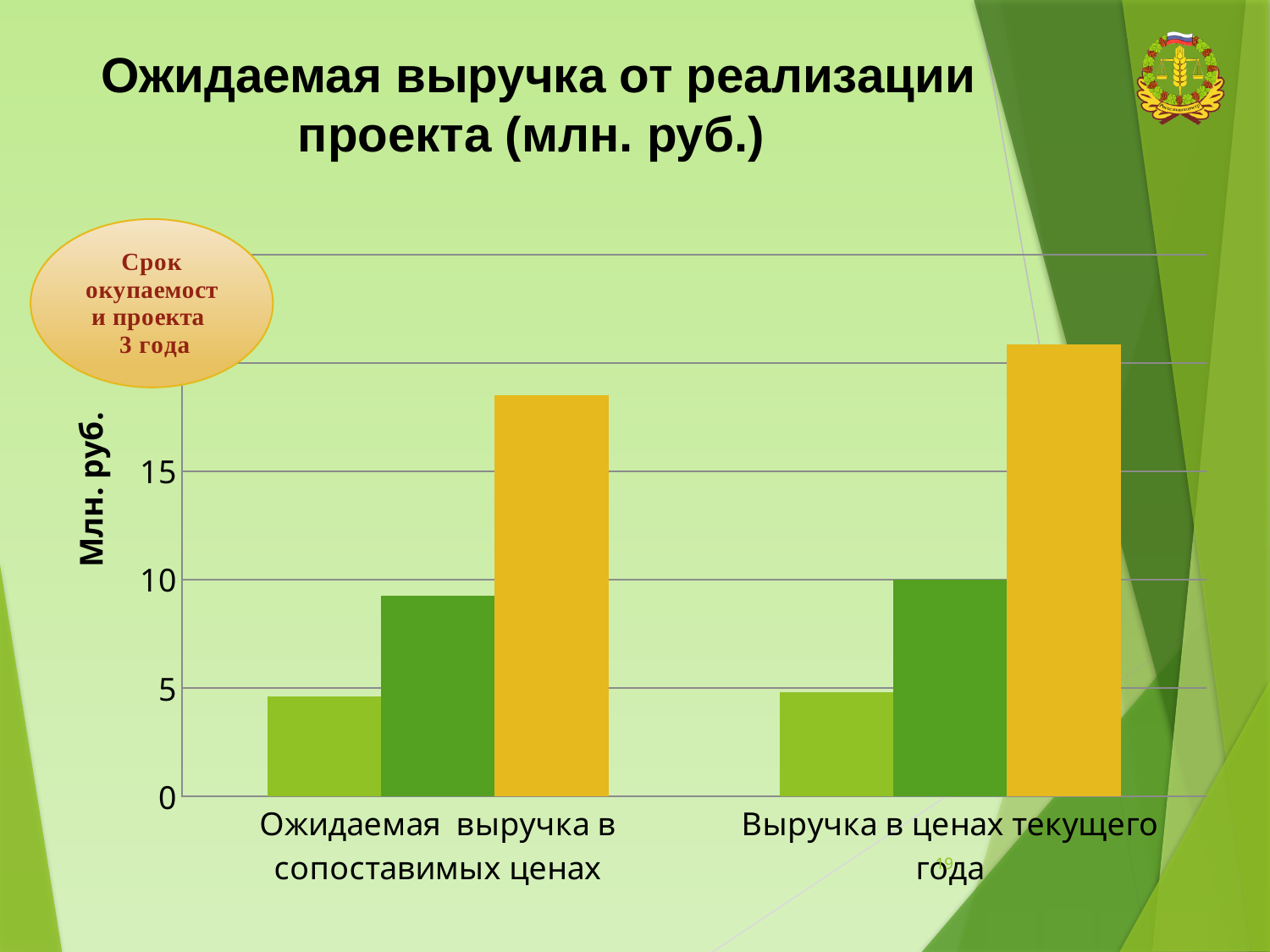
Which category has the tallest bar in the chart? Выручка в ценах текущего года What kind of chart is shown on the slide? bar chart Within the category "Выручка в ценах текущего года", which coloured bar is the highest? yellow Is the value of the light green bar for "Ожидаемая выручка в сопоставимых ценах" greater or less than 5? less How many bars are plotted for each category in the chart? 3 Which is larger: the yellow bar for "Ожидаемая выручка в сопоставимых ценах" or the yellow bar for "Выручка в ценах текущего года"? Выручка в ценах текущего года Is the value of the dark green bar for "Ожидаемая выручка в сопоставимых ценах" greater or less than 10? less Is the value of the yellow bar for "Ожидаемая выручка в сопоставимых ценах" greater or less than 15? greater What is the label of the vertical axis of the chart? Млн. руб. What is the title of the chart on the slide? Ожидаемая выручка от реализации проекта (млн. руб.) How many categories are shown on the x axis of the chart? 2